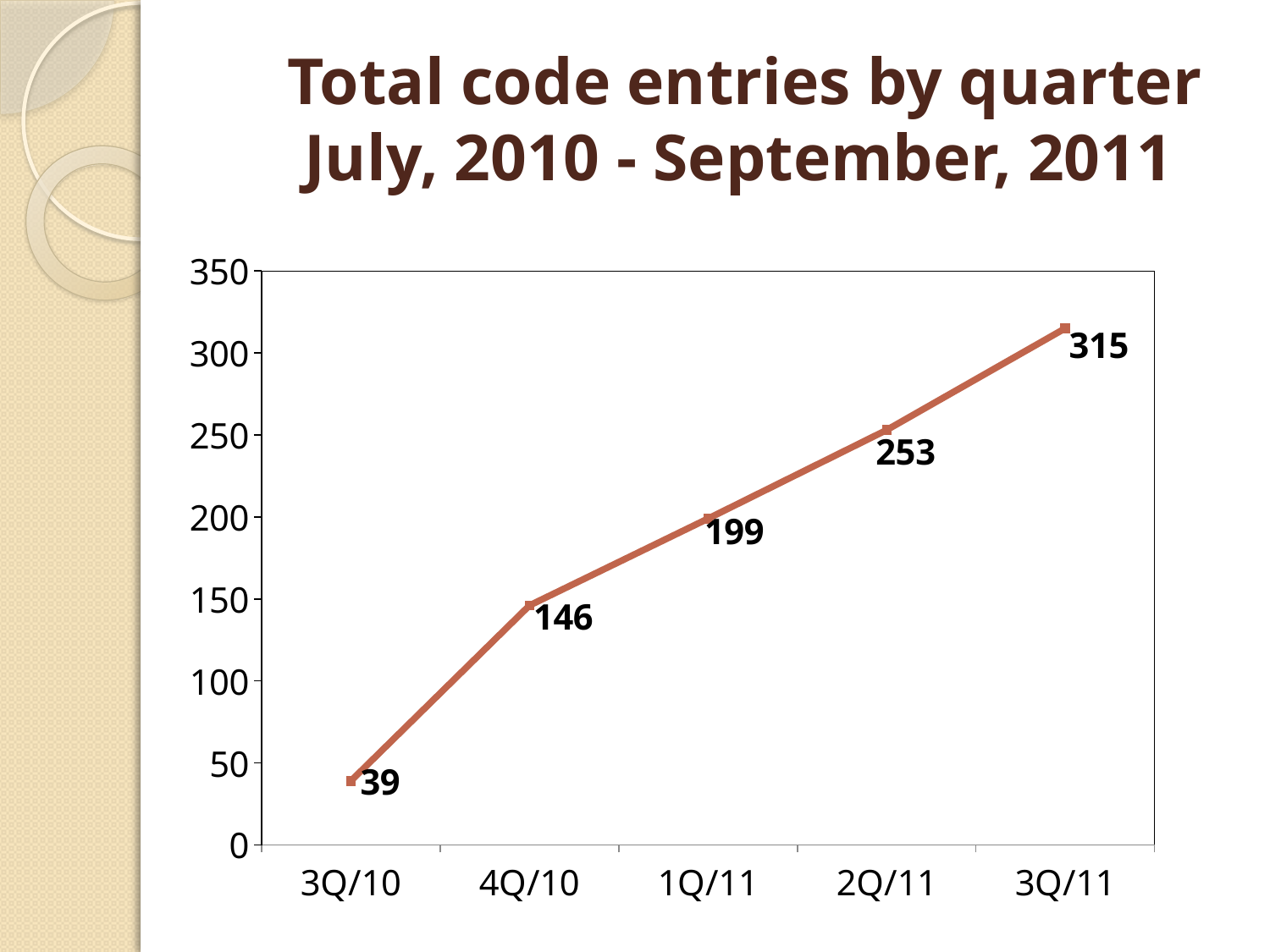
Do the values rise or fall from 3Q/10 to 3Q/11? Rise What is the value for 3Q/10? 39 What is the value for 3Q/11? 315 What kind of chart is shown on the slide? Line chart What is the difference between the values for 3Q/11 and 3Q/10? 276 What is the value for 4Q/10? 146 Which quarter has the highest value? 3Q/11 Which quarter has the lowest value? 3Q/10 How many quarters are plotted on the chart? 5 What is the value for 1Q/11? 199 What is the value for 2Q/11? 253 Which is larger, the value for 4Q/10 or the value for 1Q/11? 1Q/11